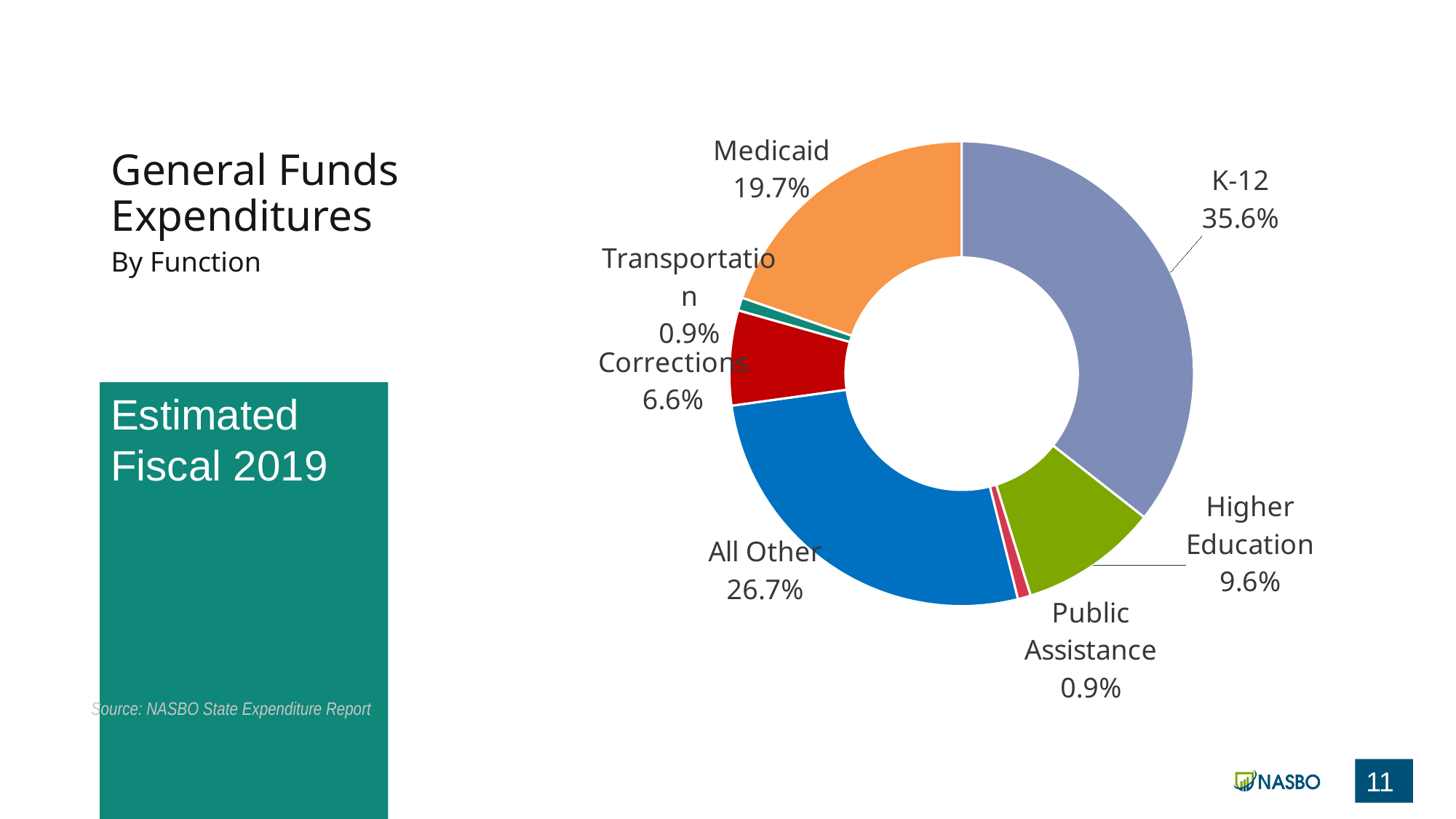
What share of general fund expenditures goes to Medicaid? 19.7% What share of general fund expenditures goes to K-12? 35.6% What kind of chart is shown on the slide? Doughnut (pie) chart Which two functions each have a share of 0.9%? Transportation and Public Assistance What fiscal year does the chart cover? Estimated Fiscal 2019 What share of general fund expenditures goes to Higher Education? 9.6% How many functions are shown in the chart? 7 What share of general fund expenditures goes to Corrections? 6.6% What is the difference in percentage points between the K-12 share and the Medicaid share? 15.9 What is the difference in percentage points between the Higher Education share and the Corrections share? 3.0 Which function has the largest share of general fund expenditures? K-12 Which function has a larger share, Medicaid or All Other? All Other